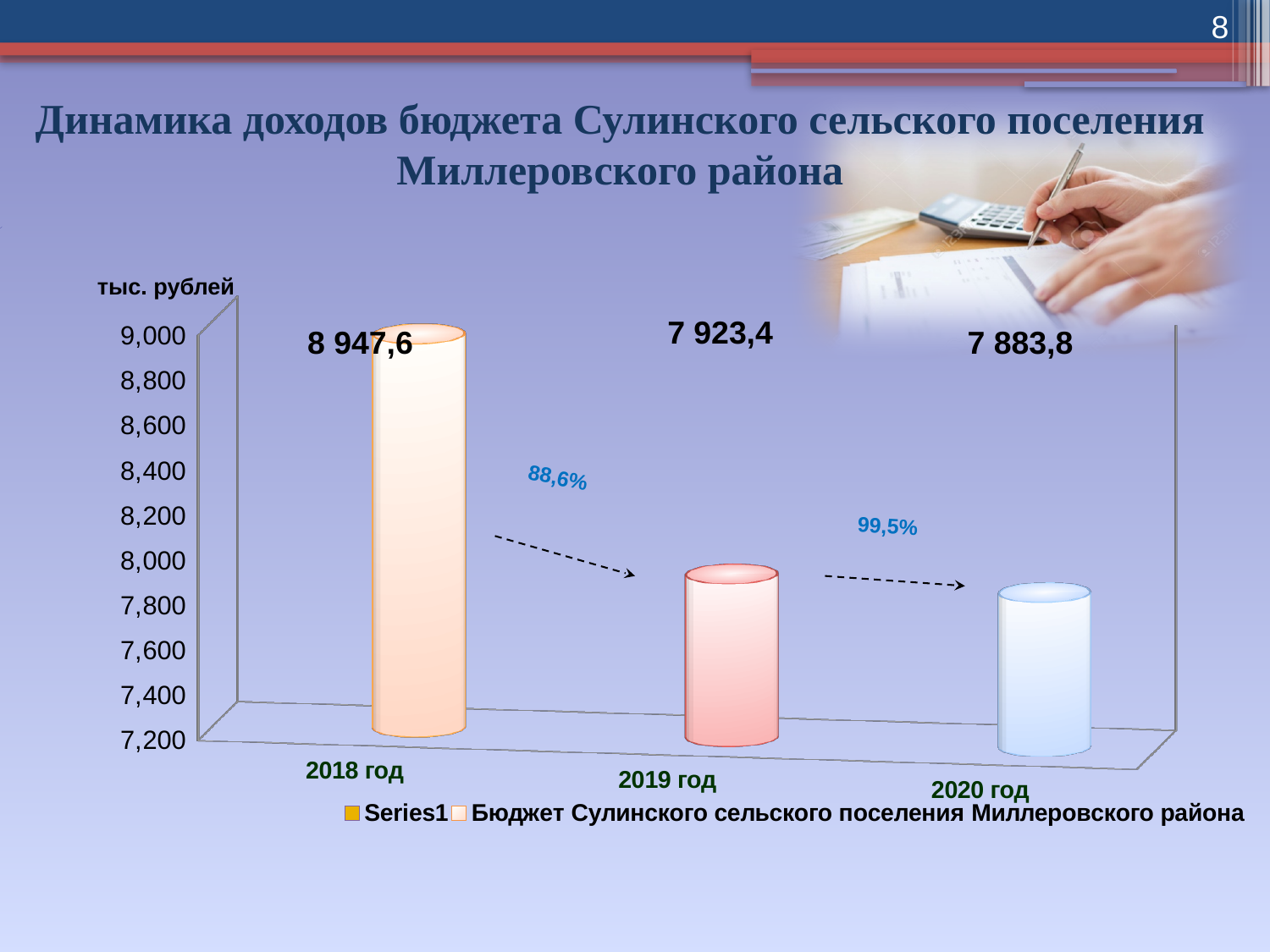
Which is larger, the value for 2018 год or the value for 2020 год? 2018 год What is the budget revenue value for 2018 год? 8 947,6 Which year has the highest budget revenue? 2018 год What kind of chart is shown on the slide? bar chart What is the difference between the 2018 год and 2019 год values? 1 024,2 Do the values rise or fall from 2018 год to 2020 год? fall Which year has the lowest budget revenue? 2020 год What is the difference between the 2019 год and 2020 год values? 39,6 How many years are shown on the x axis? 3 What is the budget revenue value for 2019 год? 7 923,4 Is the value for 2019 год greater or less than 8,000? less What is the budget revenue value for 2020 год? 7 883,8